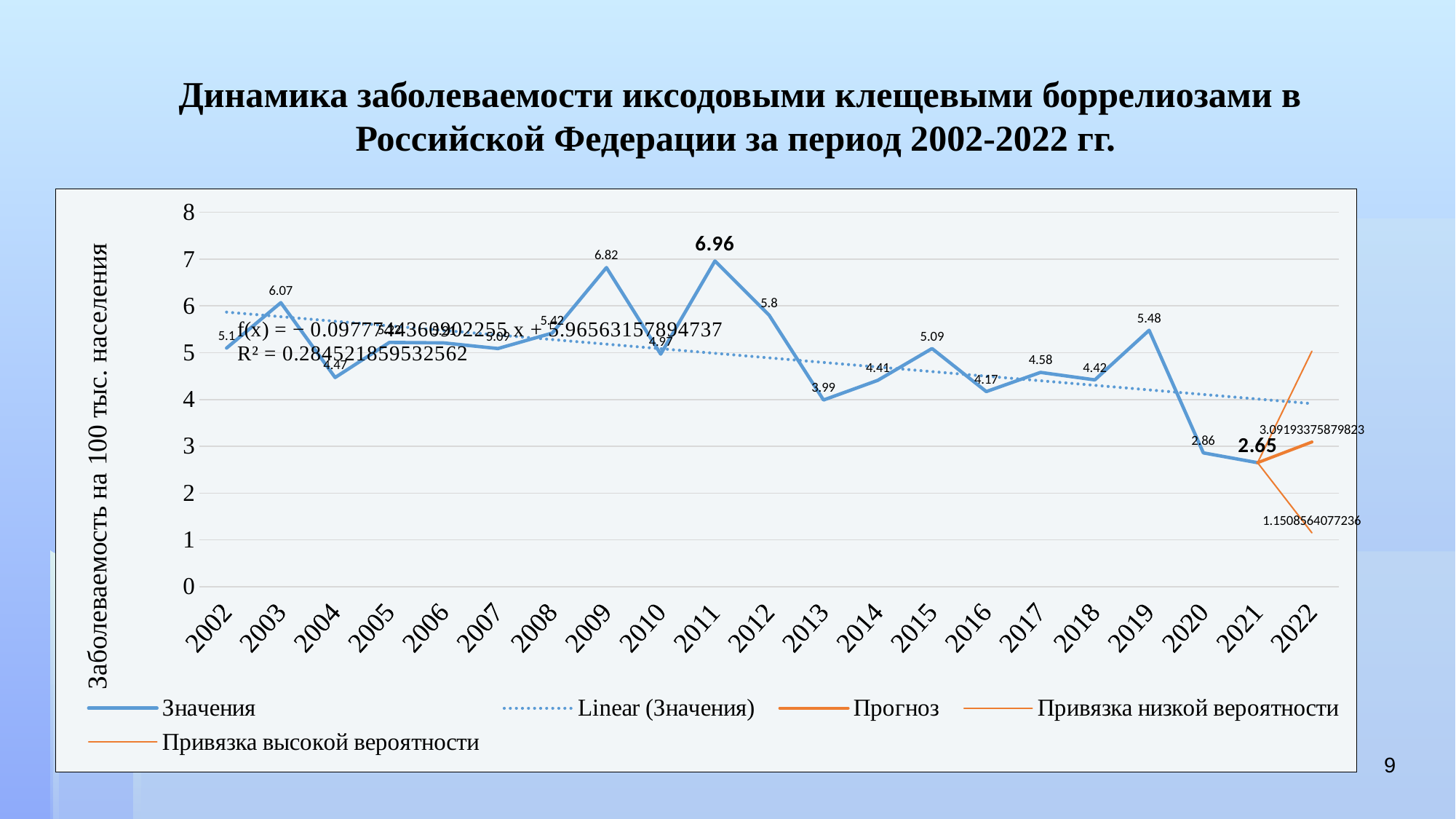
Which year has the larger value, 2003 or 2012? 2003 Does the dotted trend line (Linear (Значения)) rise or fall from 2002 to 2022? fall What is the value for 2013 on the Значения line? 3.99 Which year has the lowest value on the Значения line? 2021 Which year has the highest value on the Значения line? 2011 How many years are shown on the x axis? 21 How many series does the legend list? 5 What is the value for 2021 on the Значения line? 2.65 What kind of chart is shown on the slide? line chart What is the difference between the values for 2011 and 2013? 2.97 Is the value for 2020 greater or less than 3? less What is the value for 2009 on the Значения line? 6.82